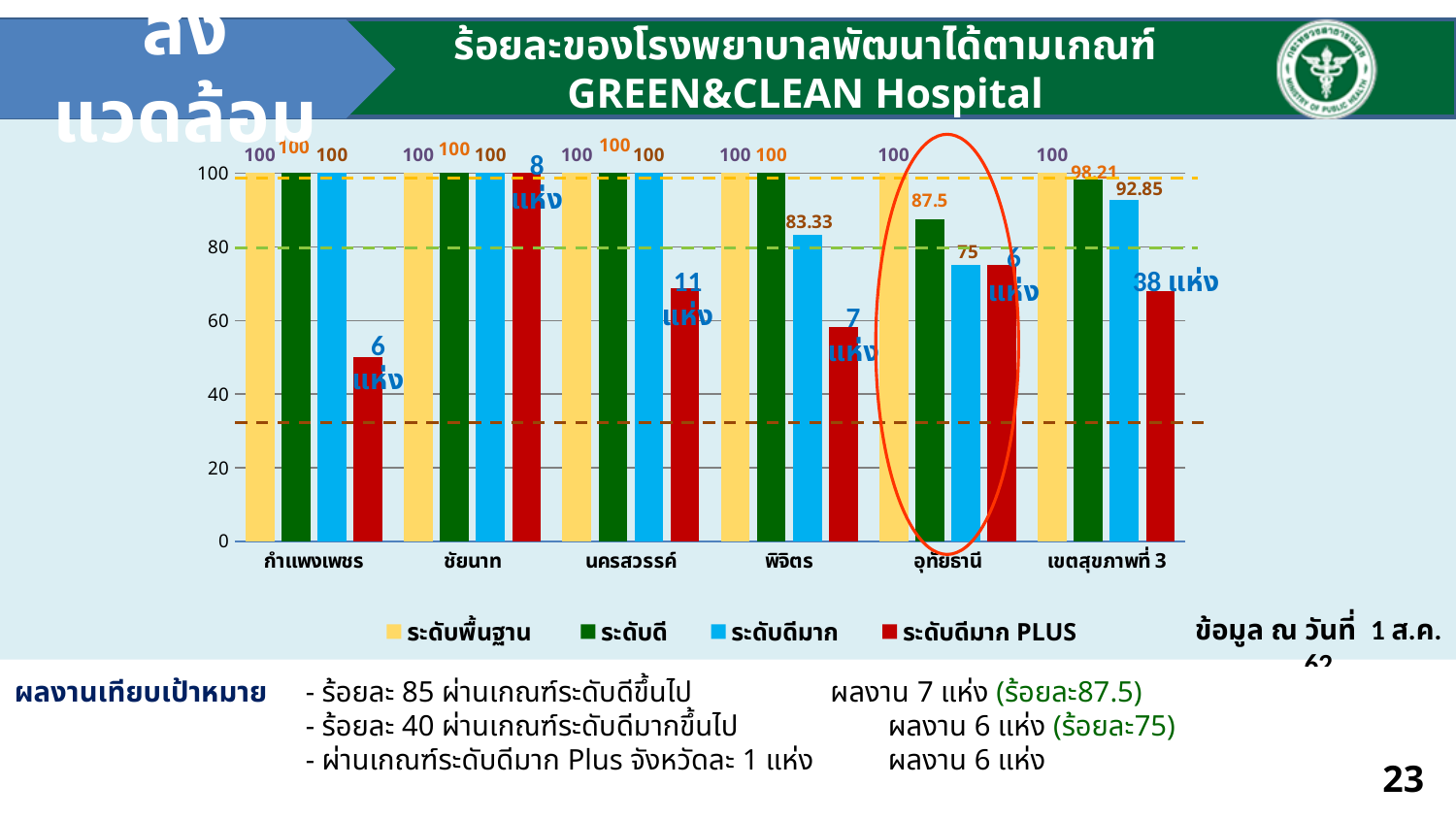
Which category has the lowest ระดับดีมาก value? อุทัยธานี How many categories are shown along the x axis of the chart? 6 What is the value of ระดับดีมาก for พิจิตร? 83.33 Is the ระดับดีมาก PLUS value for กำแพงเพชร greater or less than 60? less What is the value of ระดับดี for เขตสุขภาพที่ 3? 98.21 How many series does the chart legend list? 4 What is the value of ระดับดีมาก for อุทัยธานี? 75 What kind of chart is shown on the slide? bar chart What is the value of ระดับดี for อุทัยธานี? 87.5 What is the difference between ระดับดี and ระดับดีมาก for อุทัยธานี? 12.5 What is the value of ระดับดีมาก for เขตสุขภาพที่ 3? 92.85 Which has the higher ระดับดีมาก value, พิจิตร or อุทัยธานี? พิจิตร